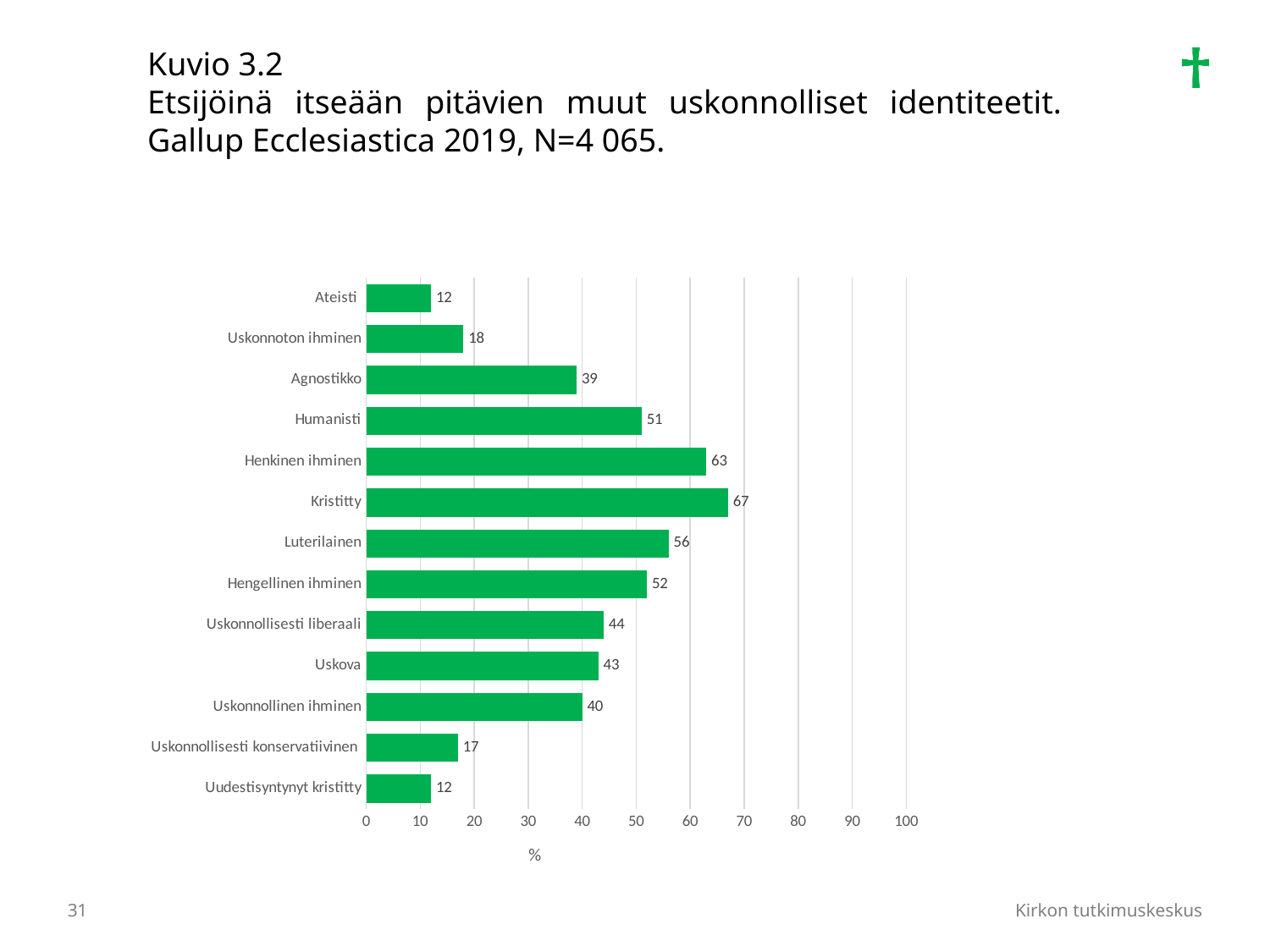
What is the value for Uskonnollisesti konservatiivinen? 17 What is the value for Kristitty? 67 Which is larger, the value for Hengellinen ihminen or the value for Uskonnollinen ihminen? Hengellinen ihminen Which category has the highest value? Kristitty How many categories are shown in the chart? 13 What unit is shown on the horizontal axis label? % What is the value for Agnostikko? 39 What is the difference between the values for Luterilainen and Uskonnoton ihminen? 38 Which is larger, the value for Humanisti or the value for Uskova? Humanisti Is the value for Luterilainen greater or less than 50? greater What is the difference between the values for Kristitty and Henkinen ihminen? 4 What kind of chart is shown on the slide? bar chart